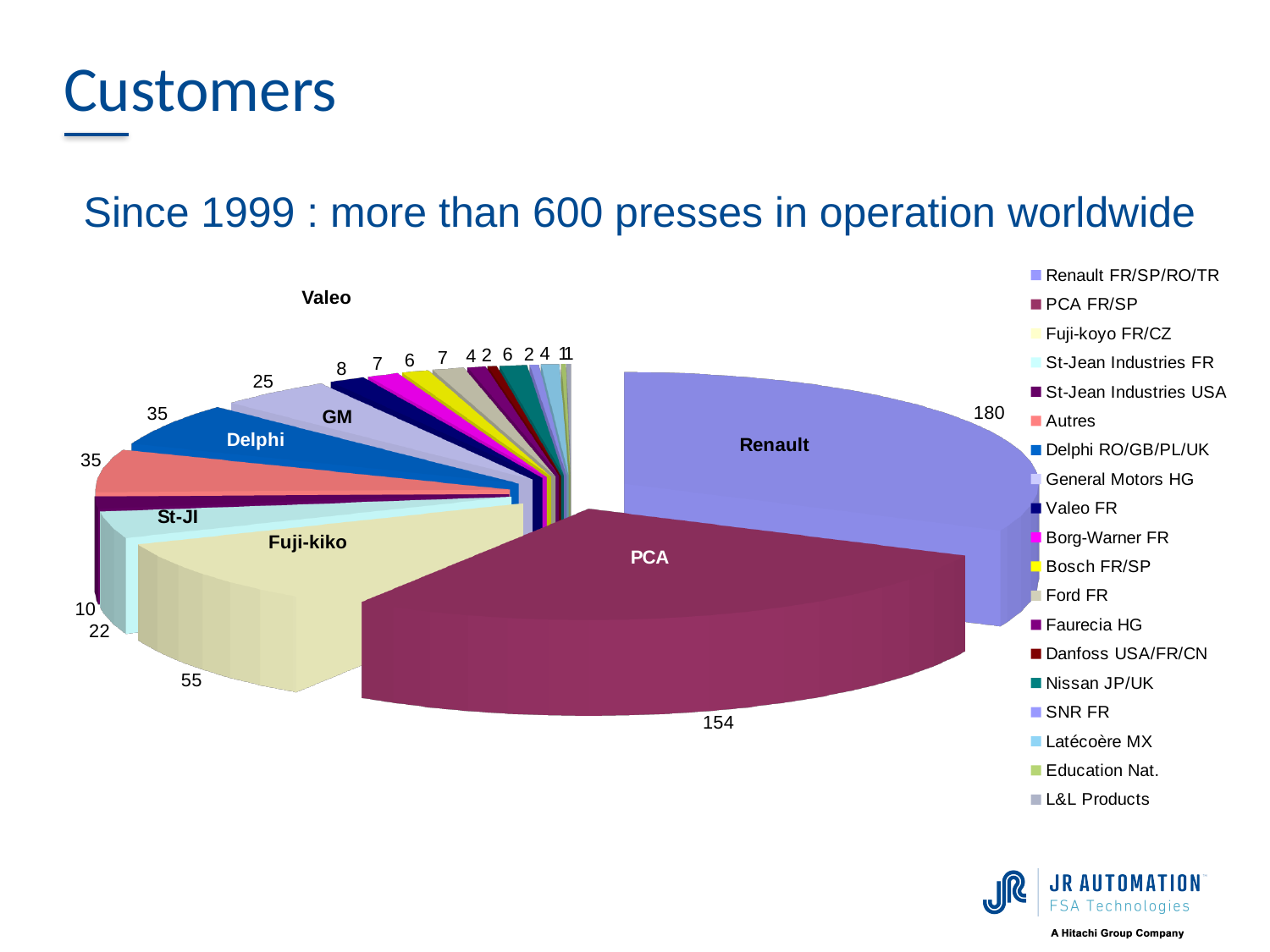
What is the value shown for the Delphi slice? 35 What is the value shown for the Valeo slice? 8 What kind of chart is shown on the slide? pie chart How many entries does the legend list? 19 What is the value shown for the Renault slice? 180 What is the first entry listed in the legend? Renault FR/SP/RO/TR Which customer has the largest slice of the pie? Renault Which is larger, the Fuji-kiko slice or the GM slice? Fuji-kiko What is the value shown for the GM slice? 25 What is the value shown for the PCA slice? 154 What is the value shown for the Fuji-kiko slice? 55 What is the difference between the Renault value and the PCA value? 26